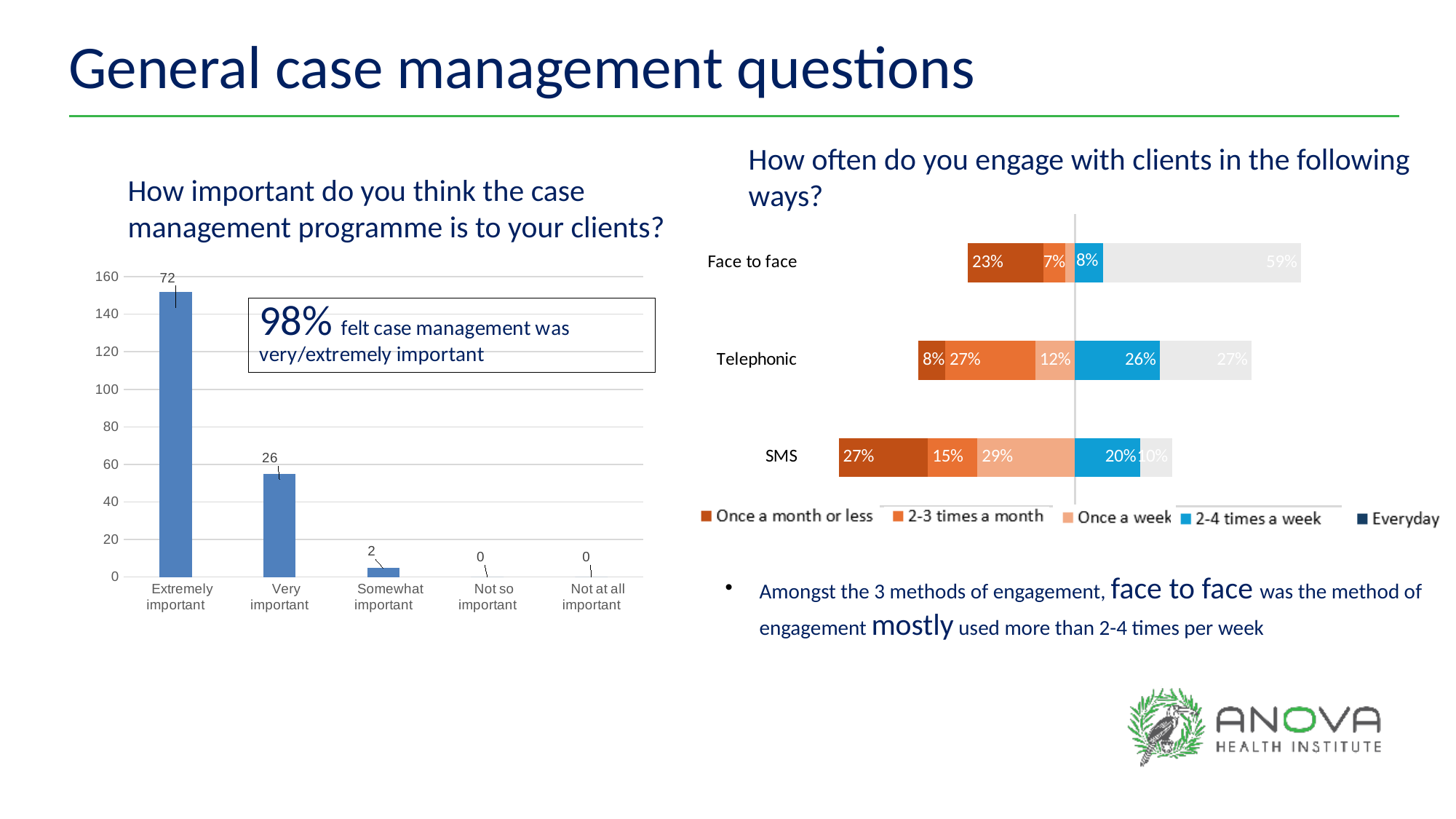
In the chart 'How important do you think the case management programme is to your clients?', what data label is shown for 'Somewhat important'? 2 In the chart 'How important do you think the case management programme is to your clients?', what data label is shown above the 'Extremely important' bar? 72 What kind of chart is 'How important do you think the case management programme is to your clients?' bar chart In the chart 'How important do you think the case management programme is to your clients?', what data label is shown above the 'Very important' bar? 26 In the chart 'How important do you think the case management programme is to your clients?', how many categories are shown on the x axis? 5 In the chart 'How important do you think the case management programme is to your clients?', is the bar for 'Extremely important' greater or less than 140 on the axis? greater How many series does the legend list in the chart 'How often do you engage with clients in the following ways?' 5 In the chart 'How often do you engage with clients in the following ways?', what percentage of Face to face engagement is 'Once a month or less'? 23% In the chart 'How often do you engage with clients in the following ways?', what is the difference between the '2-3 times a month' values for Telephonic and SMS? 12 percentage points In the chart 'How often do you engage with clients in the following ways?', what percentage of SMS engagement is 'Once a week'? 29% In the chart 'How often do you engage with clients in the following ways?', what percentage of Telephonic engagement is '2-4 times a week'? 26% In the chart 'How important do you think the case management programme is to your clients?', which category has the tallest bar? Extremely important